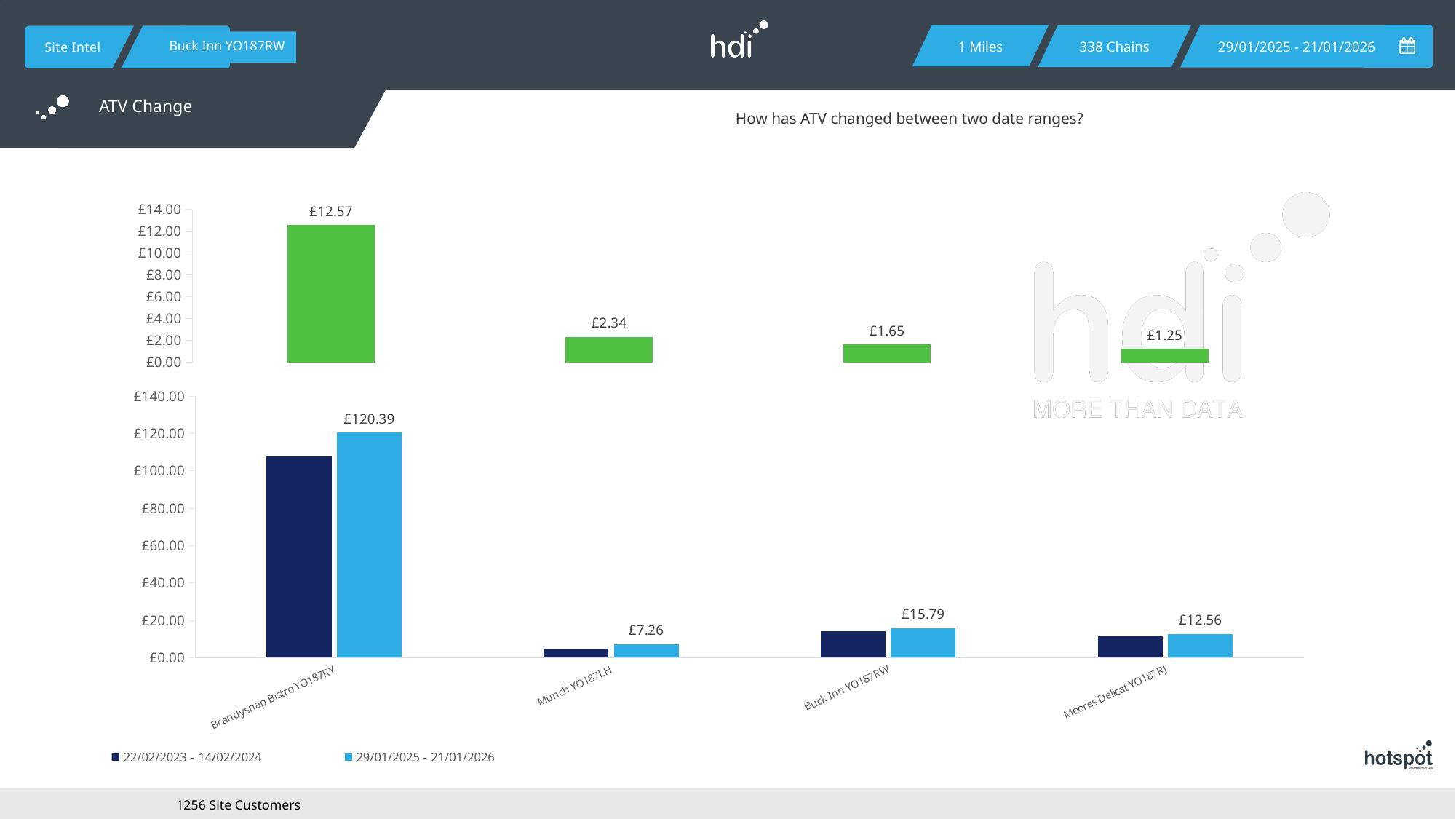
How many series does the legend of the bottom chart list? 2 In the top chart, which category has the lowest value? Moores Delicat YO187RJ In the bottom chart, what is the value for Munch YO187LH in the 29/01/2025 - 21/01/2026 series? £7.26 In the bottom chart, what is the difference between the 29/01/2025 - 21/01/2026 values for Buck Inn YO187RW and Moores Delicat YO187RJ? £3.23 In the top chart, what is the difference between the values for Brandysnap Bistro YO187RY and Munch YO187LH? £10.23 In the top chart, what is the ATV change value for Brandysnap Bistro YO187RY? £12.57 What kind of chart is the bottom chart? Bar chart In the top chart, what is the value for Buck Inn YO187RW? £1.65 In the bottom chart, what is the value for Brandysnap Bistro YO187RY in the 29/01/2025 - 21/01/2026 series? £120.39 In the bottom chart, is the 22/02/2023 - 14/02/2024 value for Brandysnap Bistro YO187RY greater or less than £100.00? greater In the bottom chart, which is larger in the 29/01/2025 - 21/01/2026 series: Buck Inn YO187RW or Moores Delicat YO187RJ? Buck Inn YO187RW In the bottom chart, which category has the highest value in the 29/01/2025 - 21/01/2026 series? Brandysnap Bistro YO187RY